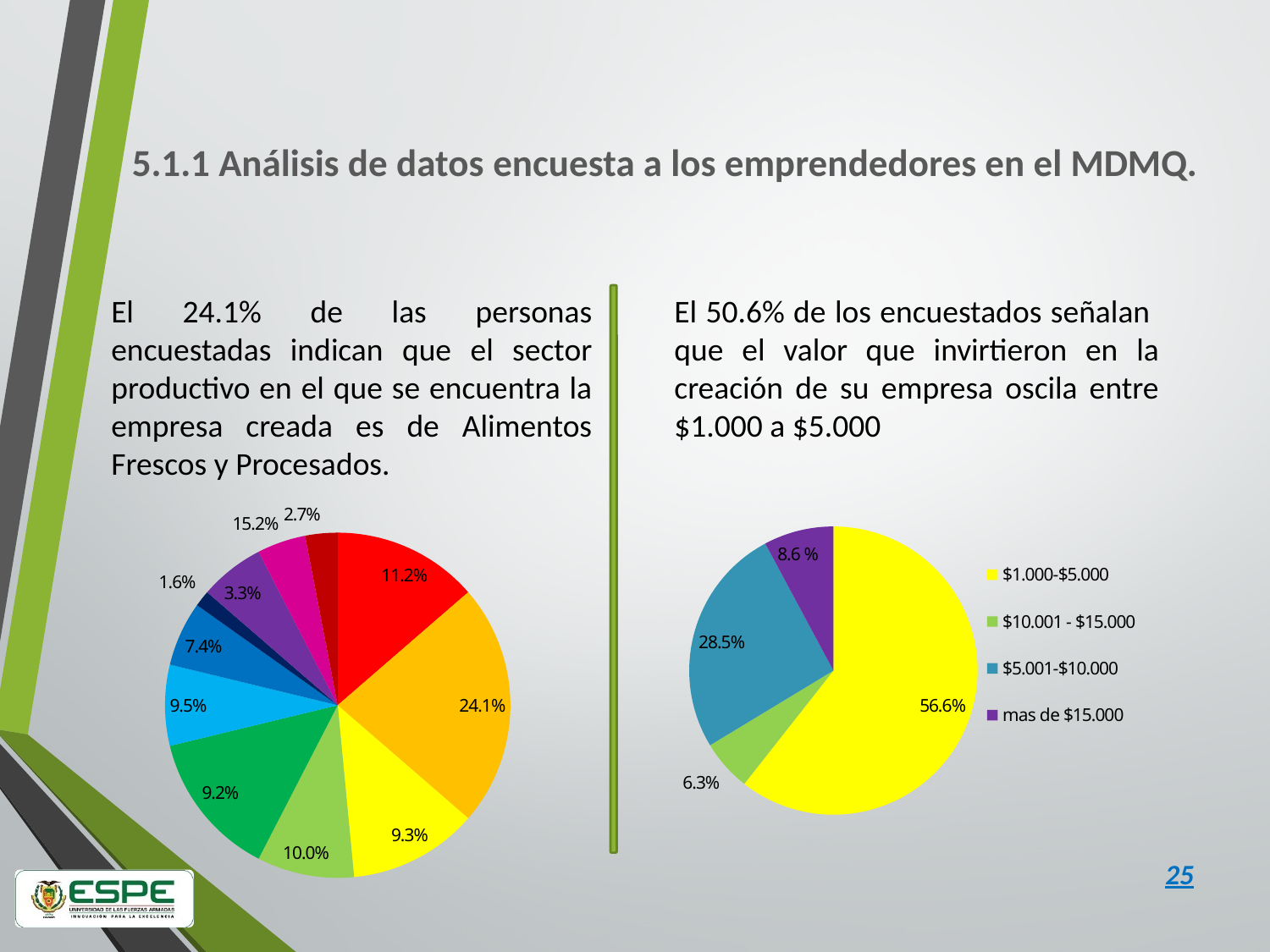
How many categories does the legend of the pie chart on the right list? 4 In the pie chart on the right, what percentage is shown for the 'mas de $15.000' category? 8.6 % In the pie chart on the right, what percentage is shown for the $1.000-$5.000 category? 56.6% How many slices does the pie chart on the left have? 11 In the pie chart on the right, what percentage is shown for the $10.001 - $15.000 category? 6.3% What type of chart is shown on the left side of the slide? Pie chart In the pie chart on the left, what is the percentage of the largest slice? 24.1% In the pie chart on the right, which category has the largest share? $1.000-$5.000 In the pie chart on the right, what percentage is shown for the $5.001-$10.000 category? 28.5% In the pie chart on the right, what is the difference between the $5.001-$10.000 share and the 'mas de $15.000' share? 19.9% In the pie chart on the right, which category has the smallest share? $10.001 - $15.000 In the pie chart on the right, which is larger: the $5.001-$10.000 share or the 'mas de $15.000' share? $5.001-$10.000